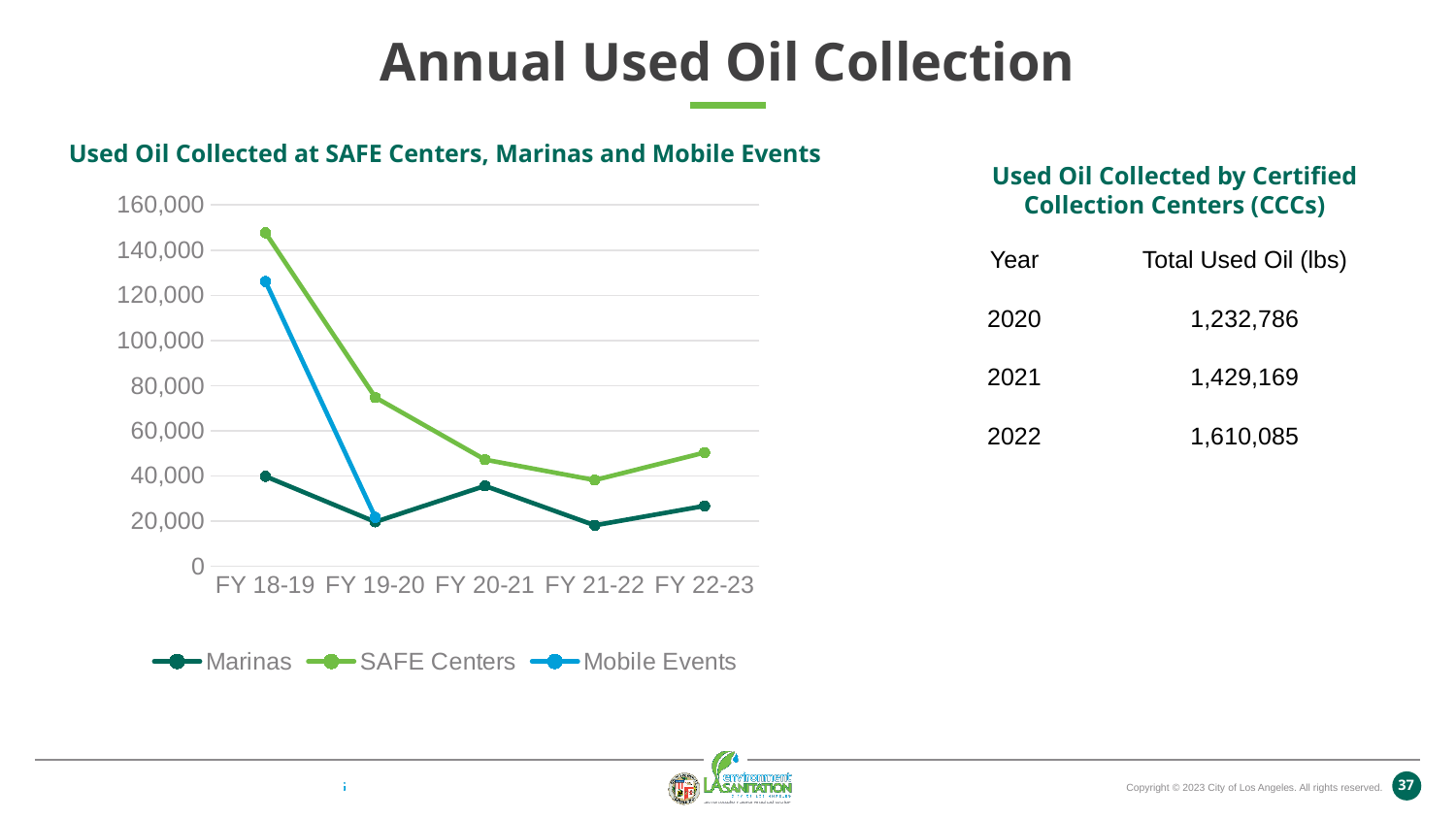
Is the value for Marinas in FY 21-22 greater or less than 40,000? less Is the value for Mobile Events in FY 18-19 greater or less than 140,000? less Is the value for SAFE Centers in FY 18-19 greater or less than 140,000? greater In the line chart, which fiscal year has the highest value for SAFE Centers? FY 18-19 In FY 22-23, which series has the larger value, SAFE Centers or Marinas? SAFE Centers What is the title of the line chart? Used Oil Collected at SAFE Centers, Marinas and Mobile Events Does the SAFE Centers line rise or fall from FY 18-19 to FY 21-22? Fall How many fiscal years are shown on the x axis of the line chart? 5 How many series does the legend of the line chart list? 3 What kind of chart is used to show used oil collected at SAFE Centers, Marinas and Mobile Events? Line chart In the line chart, which fiscal year has the lowest value for SAFE Centers? FY 21-22